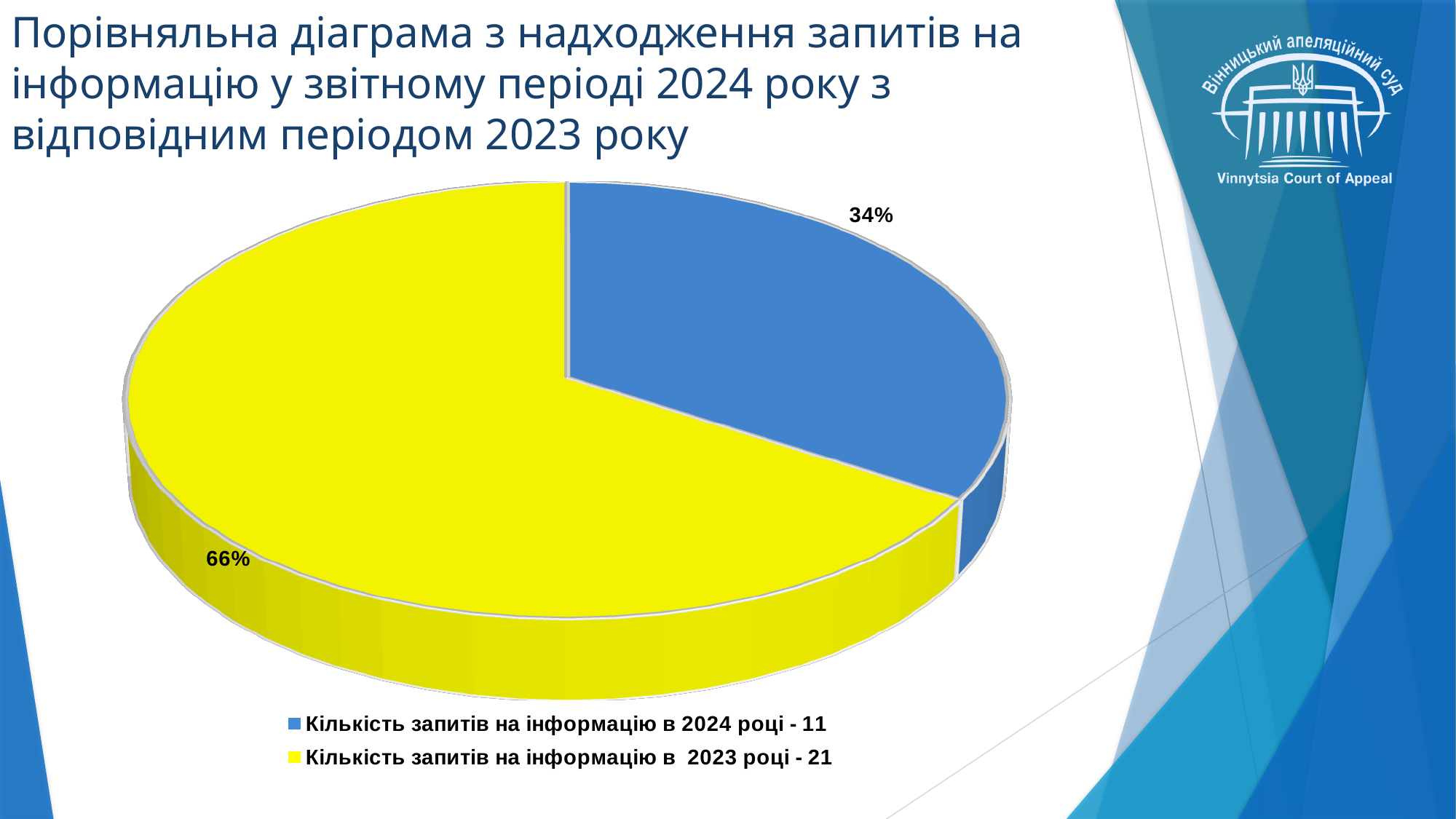
How many slices does the pie chart have? 2 Which category has the smallest share of the pie? Кількість запитів на інформацію в 2024 році - 11 Which year has the larger slice of the pie, 2023 or 2024? 2023 How many requests for information were received in 2023 according to the legend? 21 What colour is the slice representing requests in 2023? Yellow What is the difference in the number of requests between 2023 and 2024? 10 How many requests for information were received in 2024 according to the legend? 11 Which category has the largest share of the pie? Кількість запитів на інформацію в 2023 році - 21 What percentage share does the slice for requests for information in 2023 have? 66% What kind of chart is shown on the slide? Pie chart What is the difference in percentage points between the 2023 slice and the 2024 slice? 32% What percentage share does the slice for requests for information in 2024 have? 34%